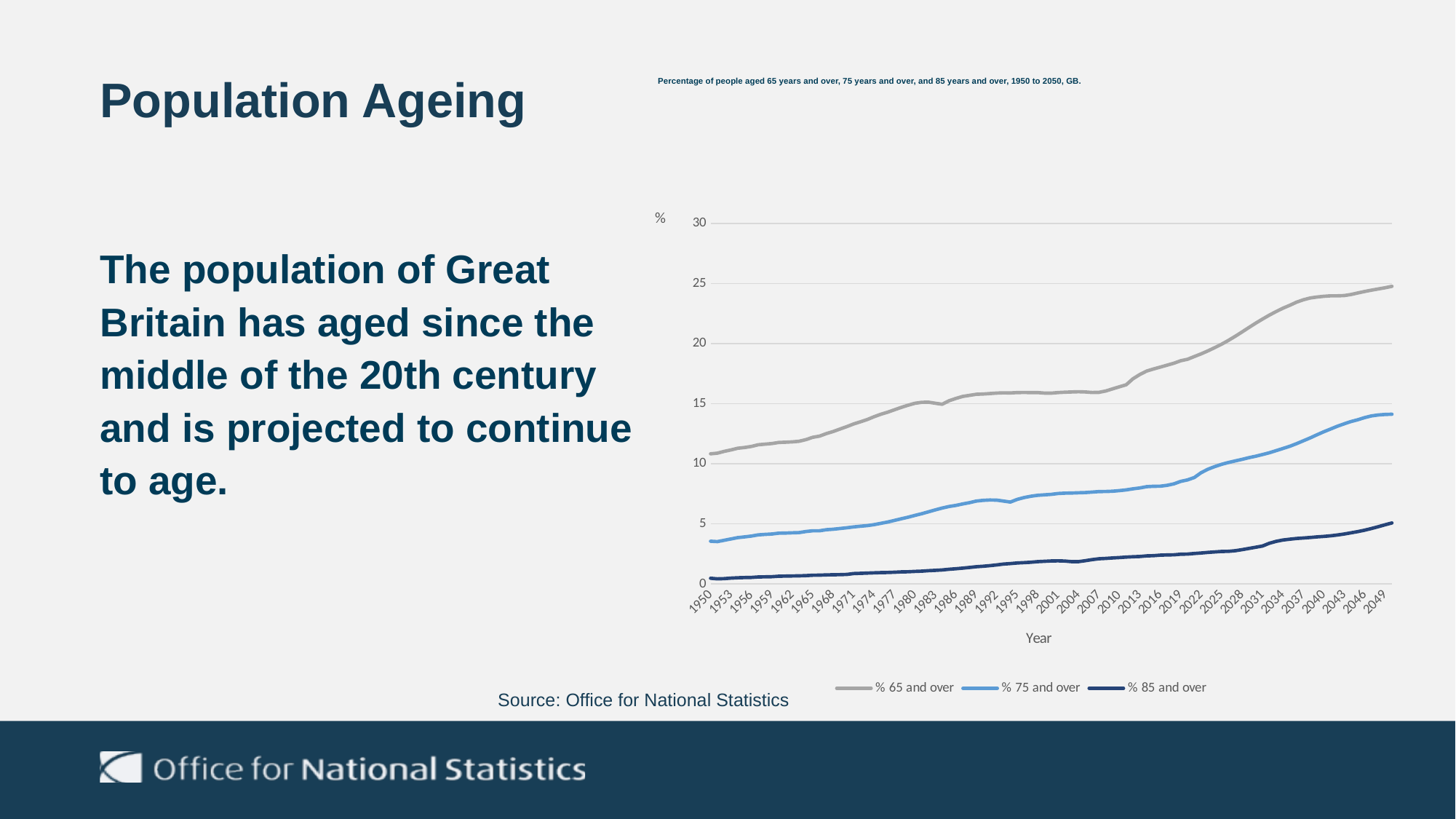
Is the value for % 75 and over in 2049 greater or less than 15? less Does the % 75 and over line rise or fall over the period shown? rise Is the value for % 75 and over in 1950 greater or less than 5? less How many series does the chart's legend list? 3 What kind of chart is shown on the slide? line chart Is the value for % 85 and over in 2049 greater or less than 10? less In 2049, which is larger: % 65 and over or % 75 and over? % 65 and over Which series has the lowest values throughout the chart? % 85 and over Which series has the highest values throughout the chart? % 65 and over What is the label on the chart's x axis? Year Does the % 65 and over line rise or fall from 1950 to 2049? rise